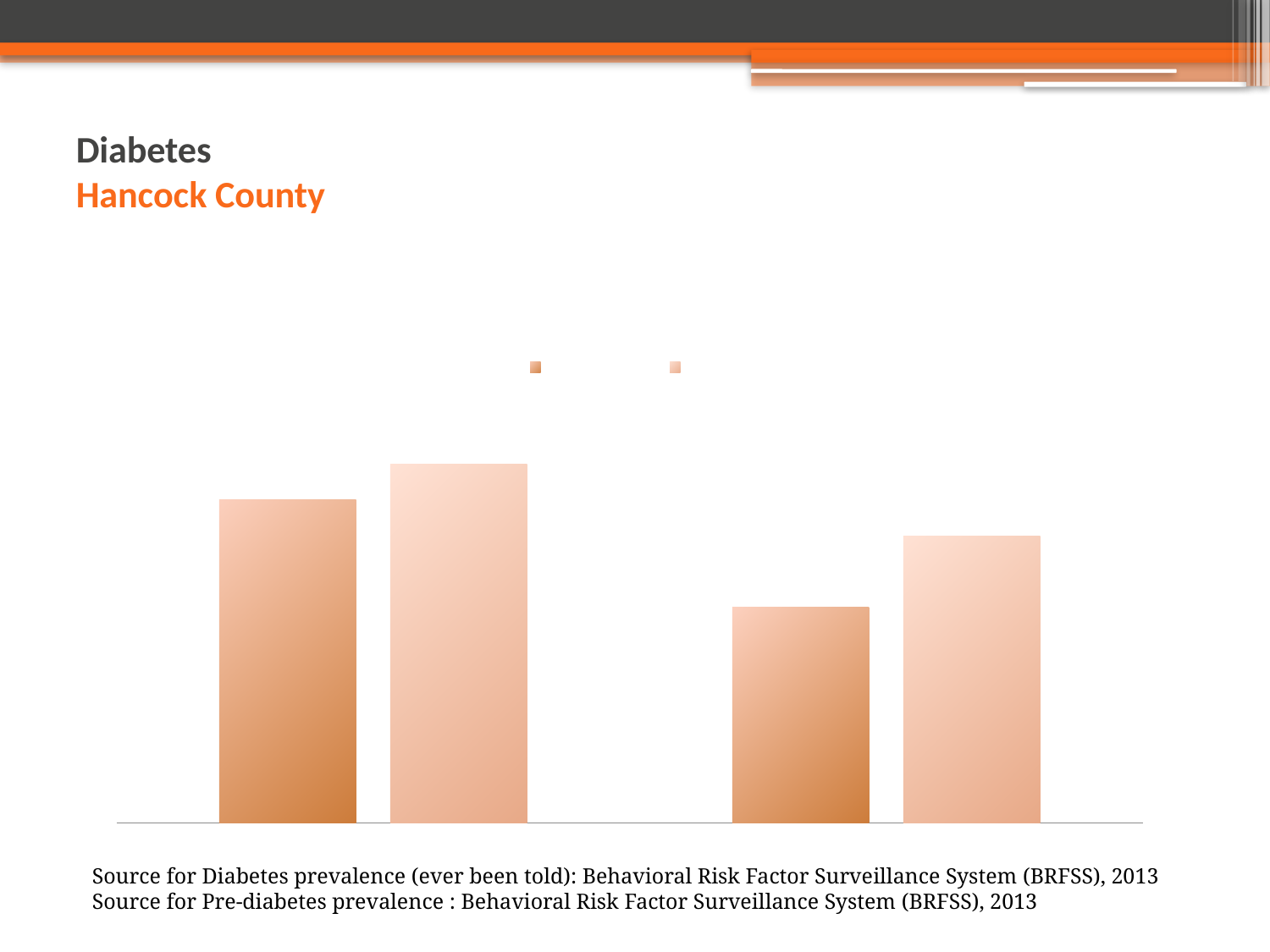
How many series does the chart's legend list? 2 Which group of bars, left or right, contains the shortest bar in the chart? right How many groups of bars are plotted in the chart? 2 How many bars are plotted in the chart in total? 4 What colour are the bars in the chart? orange In the left group of bars, is the darker orange bar or the lighter orange bar taller? the lighter orange bar Do the bar heights fall or rise moving from the left group to the right group? fall What kind of chart is shown on the slide? bar chart Which group of bars, left or right, has the tallest bar in the chart? left In the right group of bars, is the darker orange bar or the lighter orange bar taller? the lighter orange bar